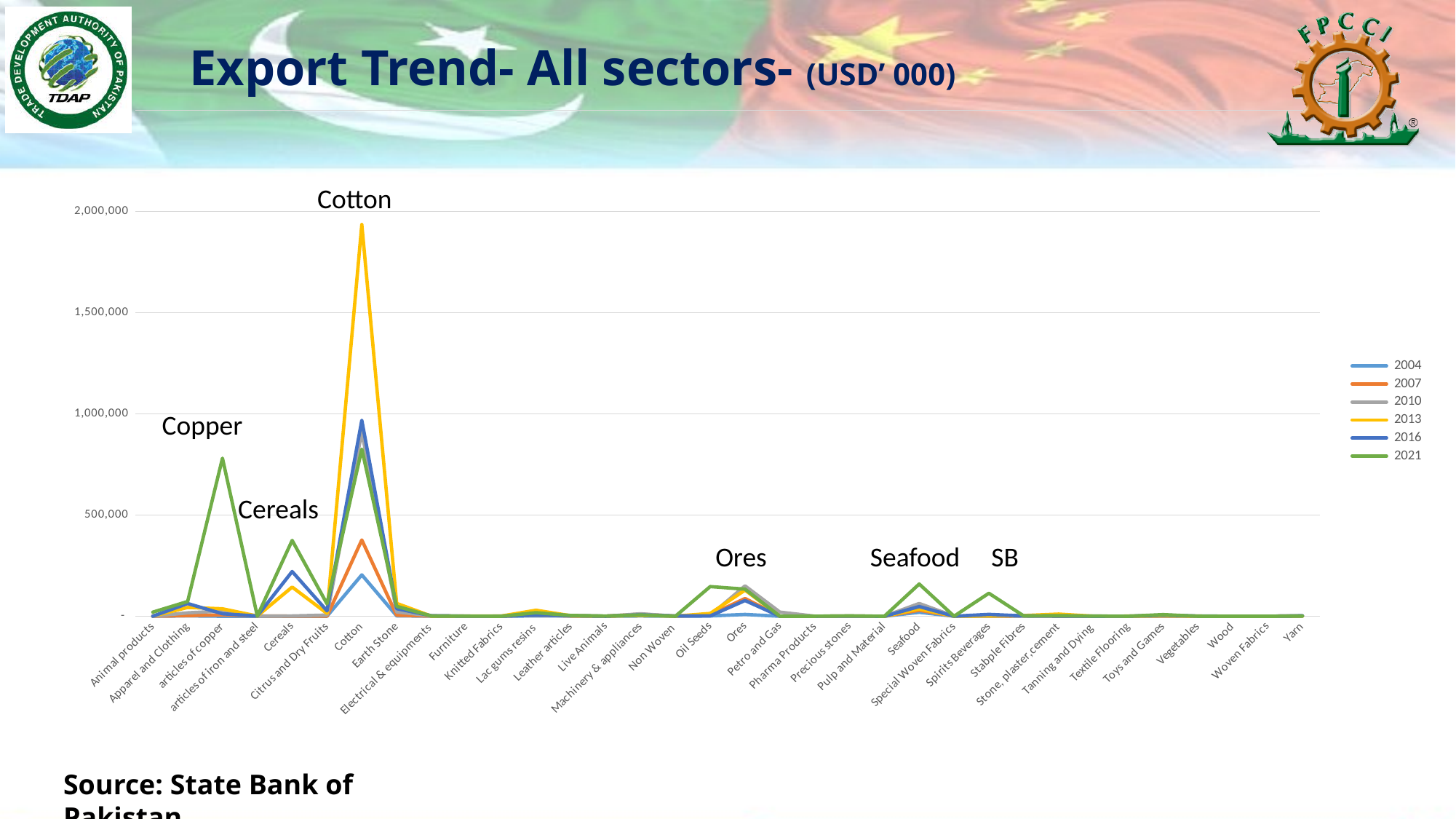
Is the 2021 value for Cereals greater or less than 500,000? less Which category has the highest value for the 2013 series? Cotton Which is larger for Cotton: the 2013 value or the 2021 value? 2013 Which years are listed in the legend? 2004, 2007, 2010, 2013, 2016, 2021 How many sector categories are shown on the x axis? 34 What is the title of the chart slide? Export Trend- All sectors- (USD' 000) Is the 2021 value for articles of copper greater or less than 500,000? greater Which series has the highest value at articles of copper? 2021 What kind of chart is shown on the slide? line chart How many series does the legend list? 6 Which series has the lowest value at Cotton? 2004 Is the 2013 value for Cotton greater or less than 1,500,000? greater